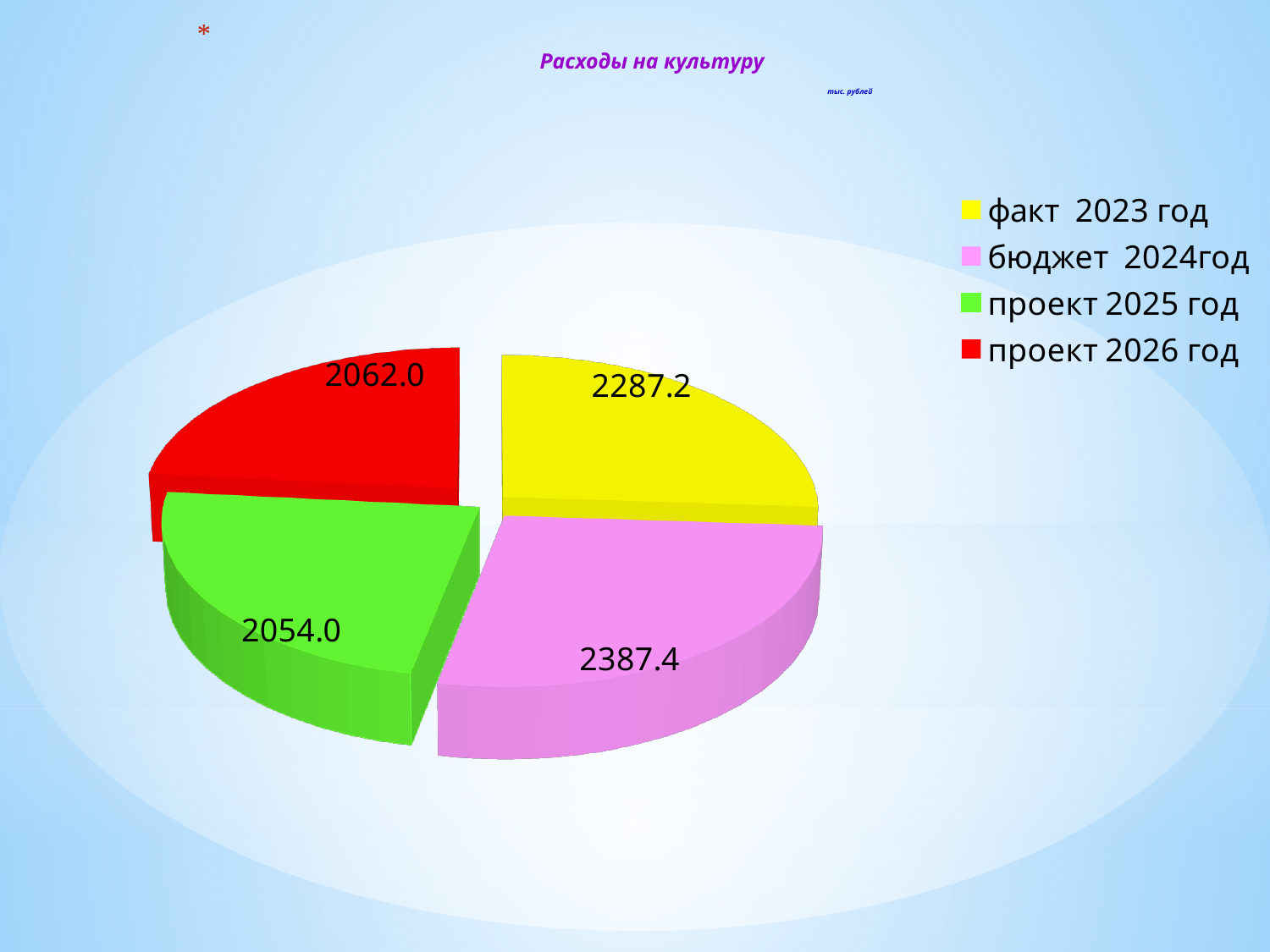
What is the value for бюджет 2024год? 2387.4 What is the difference between the values for проект 2026 год and проект 2025 год? 8.0 What type of chart is shown on the slide? Pie chart Which is larger, the value for факт 2023 год or the value for проект 2026 год? факт 2023 год What is the value for факт 2023 год? 2287.2 What is the difference between the values for бюджет 2024год and факт 2023 год? 100.2 What is the value for проект 2026 год? 2062.0 Which category has the smallest slice? проект 2025 год What is the title of the chart? Расходы на культуру How many slices does the pie chart have? 4 What is the value for проект 2025 год? 2054.0 Which category has the largest slice? бюджет 2024год